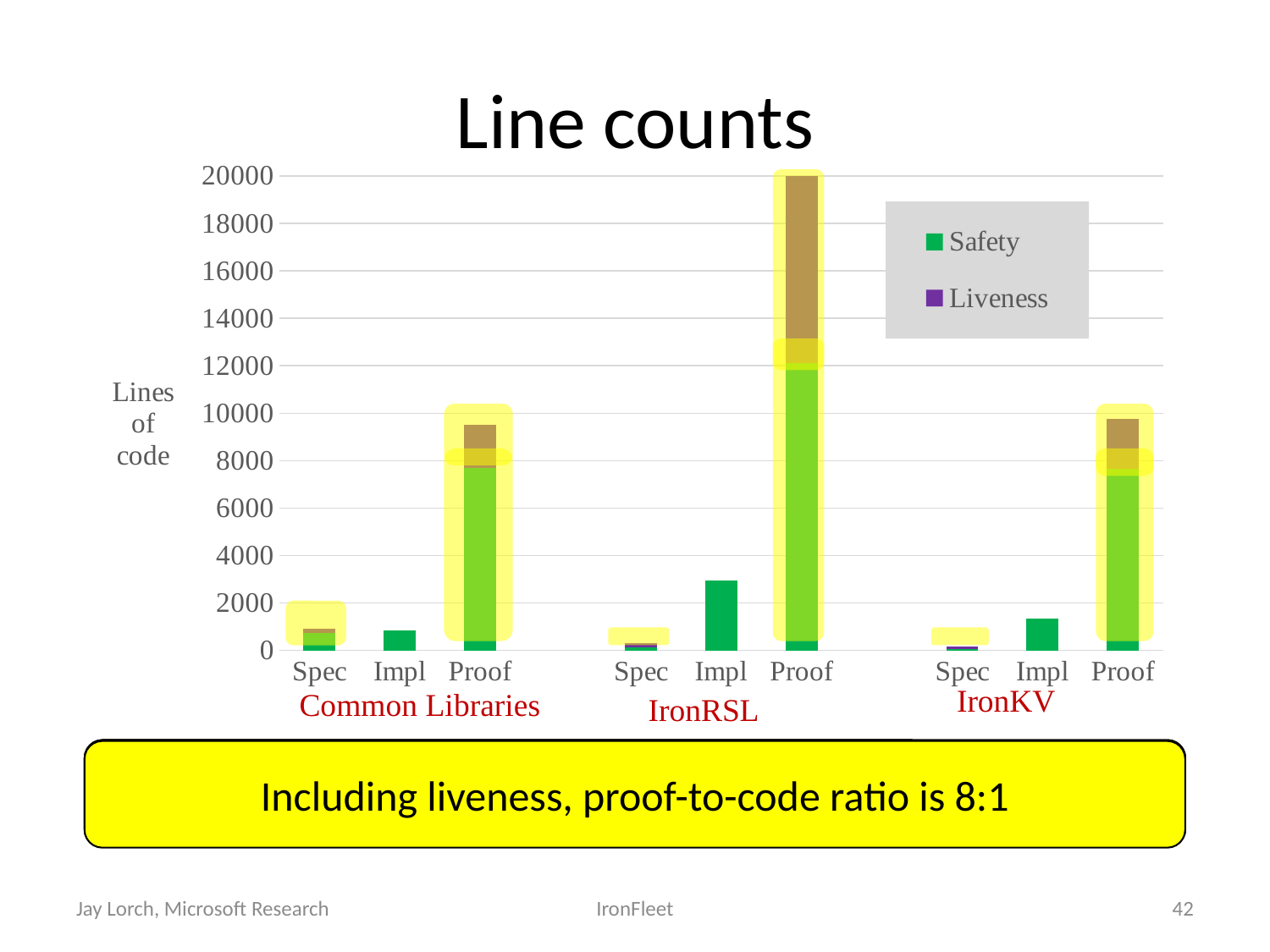
Is the value for IronRSL Impl greater or less than 2000? greater What is the title of the chart? Line counts Which bar is the tallest in the chart? IronRSL Proof Is the value for Common Libraries Impl greater or less than 2000? less Is the value for IronRSL Proof greater or less than 18000? greater Which is larger, the Impl bar for IronRSL or the Impl bar for IronKV? IronRSL How many series does the legend list? 2 What kind of chart is shown on the slide? bar chart How many bars are plotted in the chart? 9 Which is larger, the Proof bar for IronRSL or the Proof bar for Common Libraries? IronRSL What are the two series named in the legend? Safety and Liveness